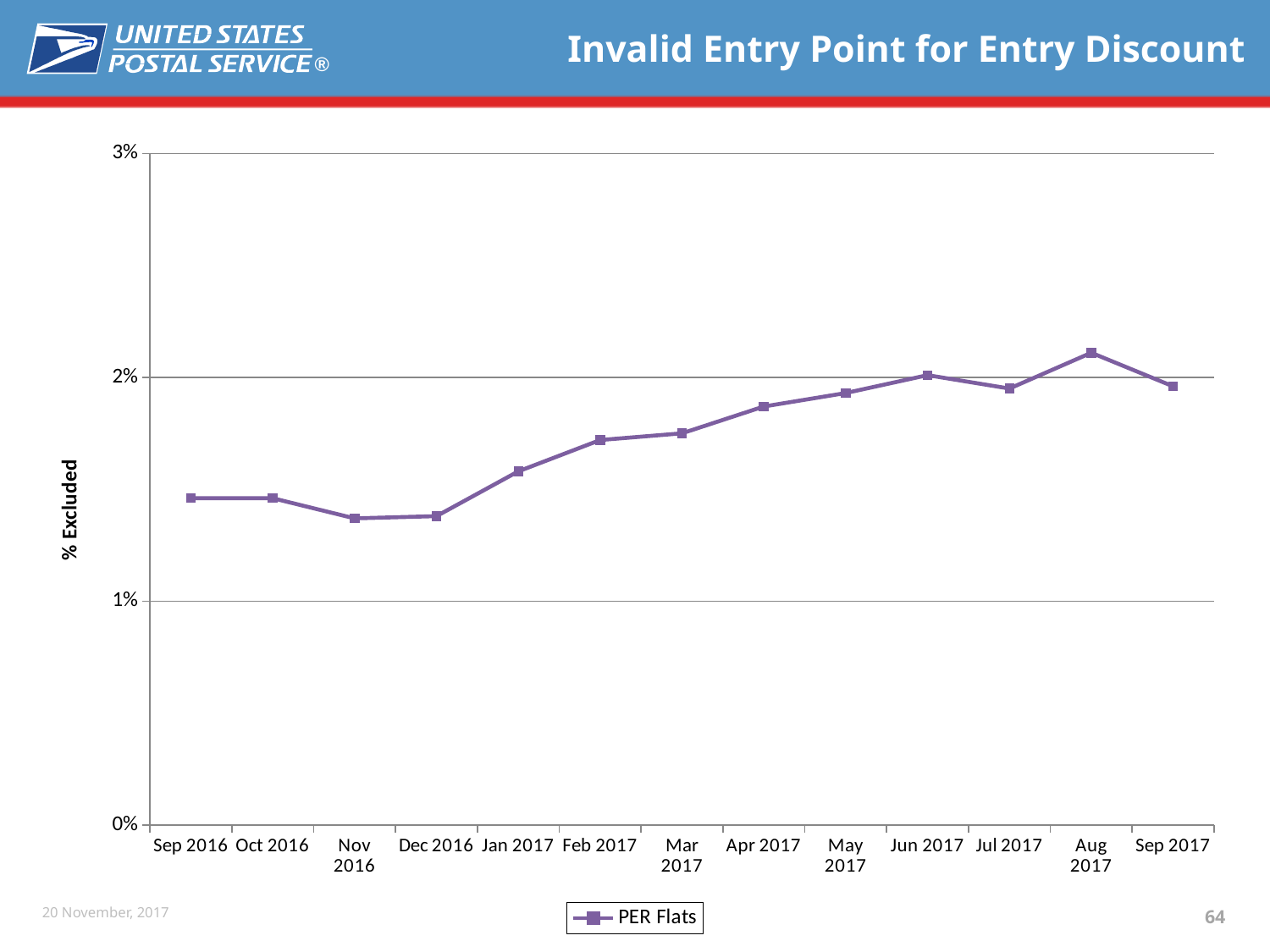
Which is larger, the value for Feb 2017 or the value for Nov 2016? Feb 2017 Which month has the highest % Excluded value? Aug 2017 Is the value for Nov 2016 greater or less than 1%? greater Overall, do the values rise or fall from Sep 2016 to Sep 2017? rise Is the value for Aug 2017 greater or less than 2%? greater Is the value for Sep 2016 greater or less than 2%? less What is the label on the vertical axis? % Excluded How many months are plotted along the x axis? 13 What is the name of the series shown in the legend? PER Flats What kind of chart is shown on the slide? line chart How many series does the legend list? 1